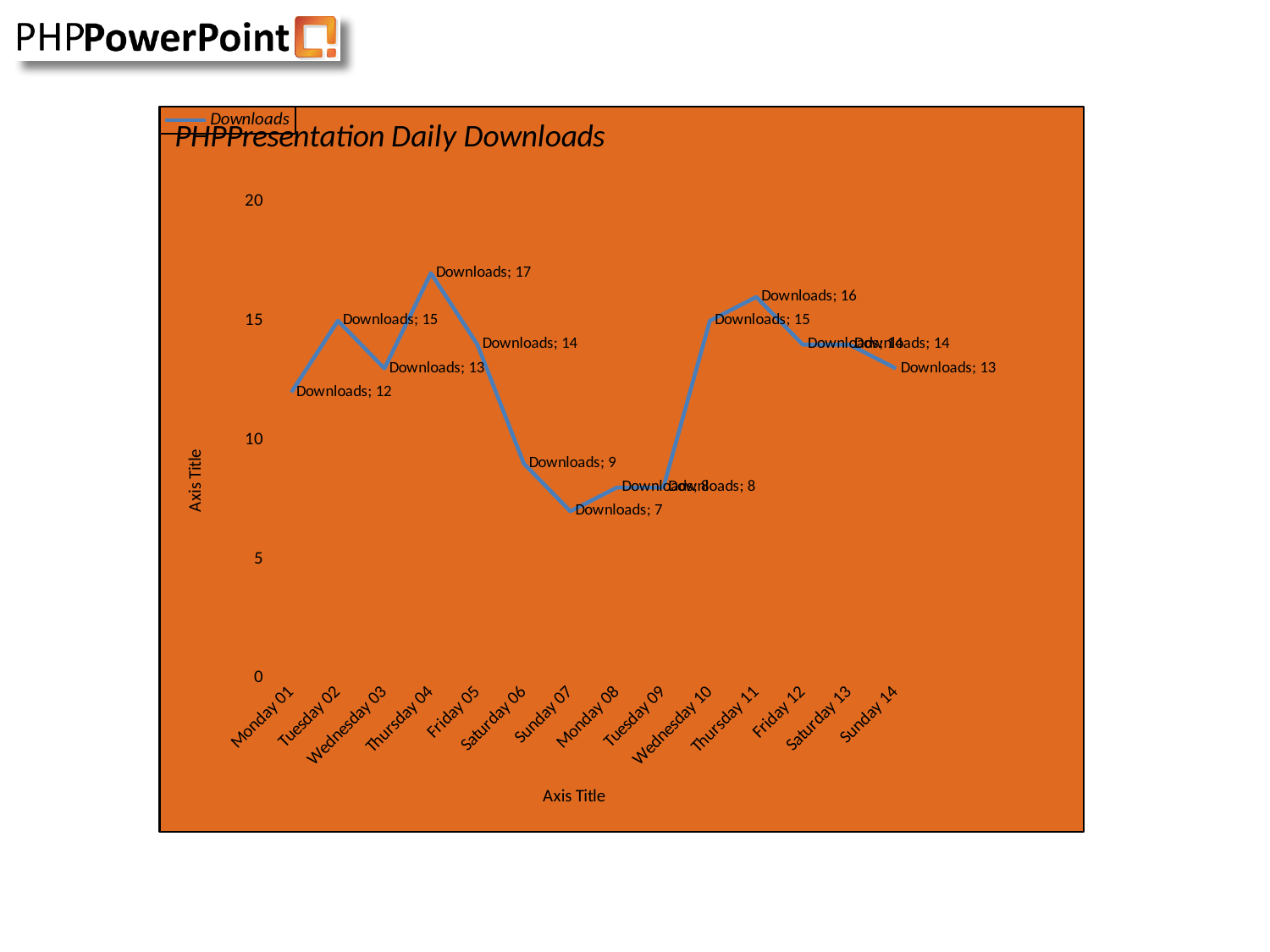
What is the Downloads value for Monday 01? 12 How many categories are plotted along the x axis? 14 What is the difference between the Downloads values for Thursday 04 and Sunday 07? 10 Which day has the lowest Downloads value? Sunday 07 How many series does the legend list? 1 What is the Downloads value for Sunday 07? 7 Which day has the highest Downloads value? Thursday 04 Which has a larger Downloads value, Tuesday 02 or Wednesday 03? Tuesday 02 What type of chart is shown on the slide? line chart Do the Downloads values rise or fall from Thursday 04 to Sunday 07? fall What is the title of the chart? PHPPresentation Daily Downloads What is the Downloads value for Thursday 04? 17